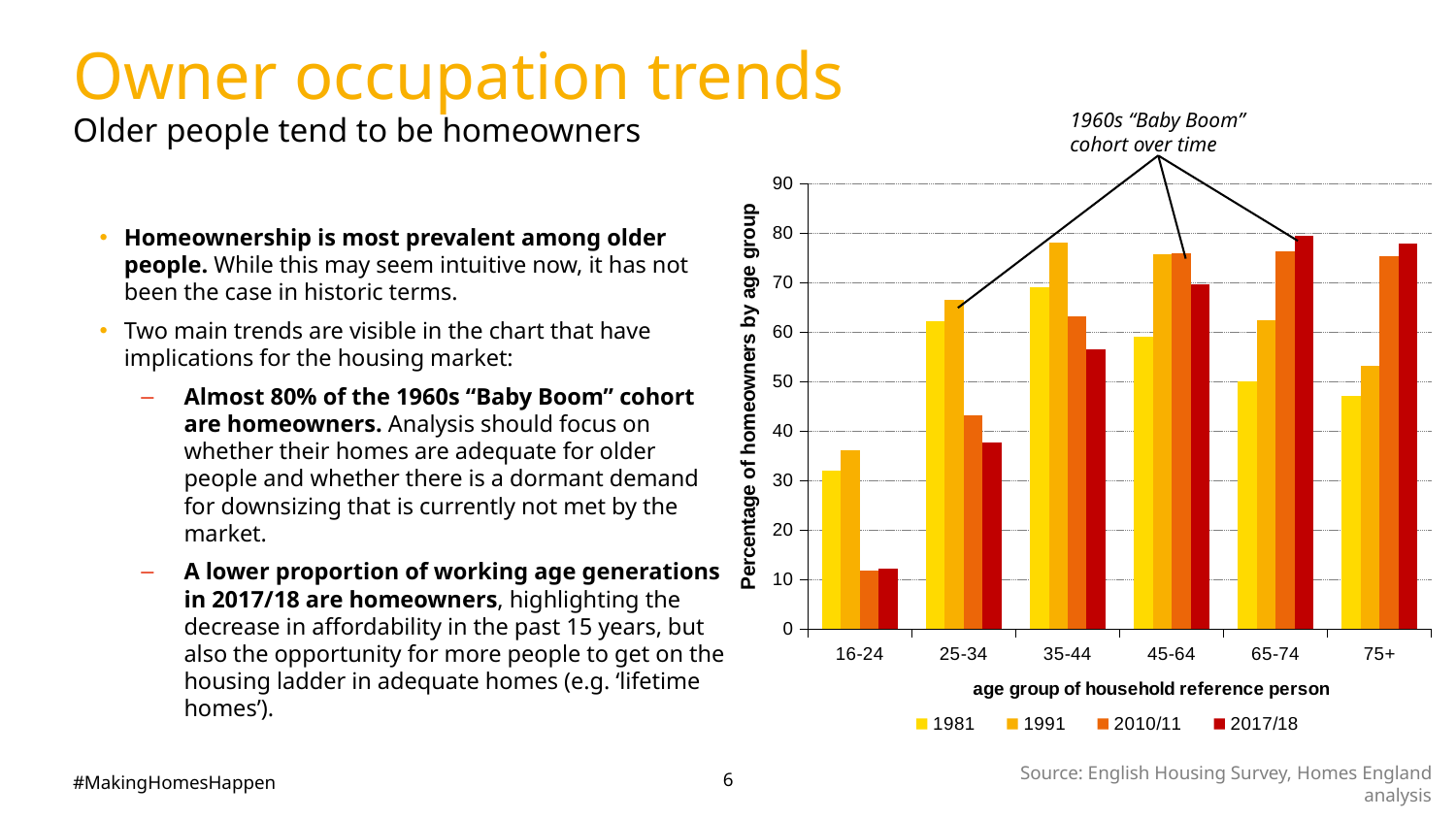
What kind of chart is shown on the slide? bar chart Which age group has the lowest value in the 2017/18 series? 16-24 For the 16-24 age group, which is larger: the 1981 value or the 2017/18 value? 1981 For the 65-74 age group, which is larger: the 1981 value or the 2017/18 value? 2017/18 Is the value for the 25-34 age group in 2017/18 greater or less than 40? less Is the value for the 75+ age group in 1981 greater or less than 50? less How many age groups are shown on the x axis of the chart? 6 How many series does the chart legend list? 4 Is the value for the 65-74 age group in 2017/18 greater or less than 70? greater What is the title of the y axis of the chart? Percentage of homeowners by age group